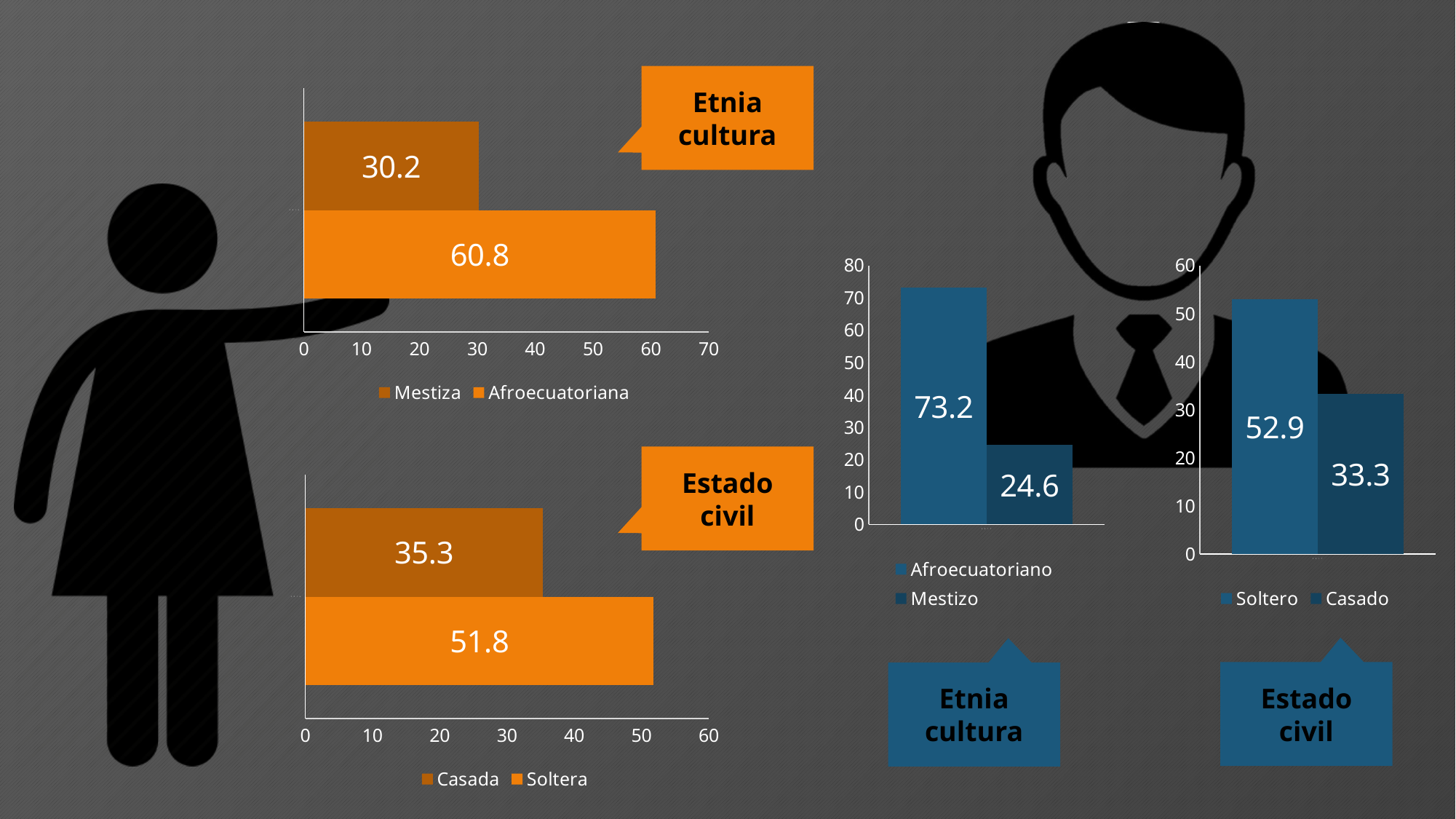
In the blue 'Estado civil' chart on the right, which is larger, Soltero or Casado? Soltero In the orange 'Estado civil' chart on the left, what are the two legend entries? Casada and Soltera In the orange 'Estado civil' chart on the left, what is the value for Soltera? 51.8 In the orange 'Estado civil' chart on the left, what is the difference between Soltera and Casada? 16.5 In the orange 'Etnia cultura' chart on the left, what is the value for Afroecuatoriana? 60.8 In the blue 'Etnia cultura' chart on the right, which series has the lowest value? Mestizo In the blue 'Etnia cultura' chart on the right, what is the value for Afroecuatoriano? 73.2 How many series does the legend of the blue 'Estado civil' chart on the right list? 2 In the orange 'Etnia cultura' chart on the left, what is the value for Mestiza? 30.2 In the blue 'Etnia cultura' chart on the right, what is the difference between Afroecuatoriano and Mestizo? 48.6 What kind of chart is the orange 'Etnia cultura' chart on the left? Bar chart In the blue 'Estado civil' chart on the right, what is the value for Casado? 33.3